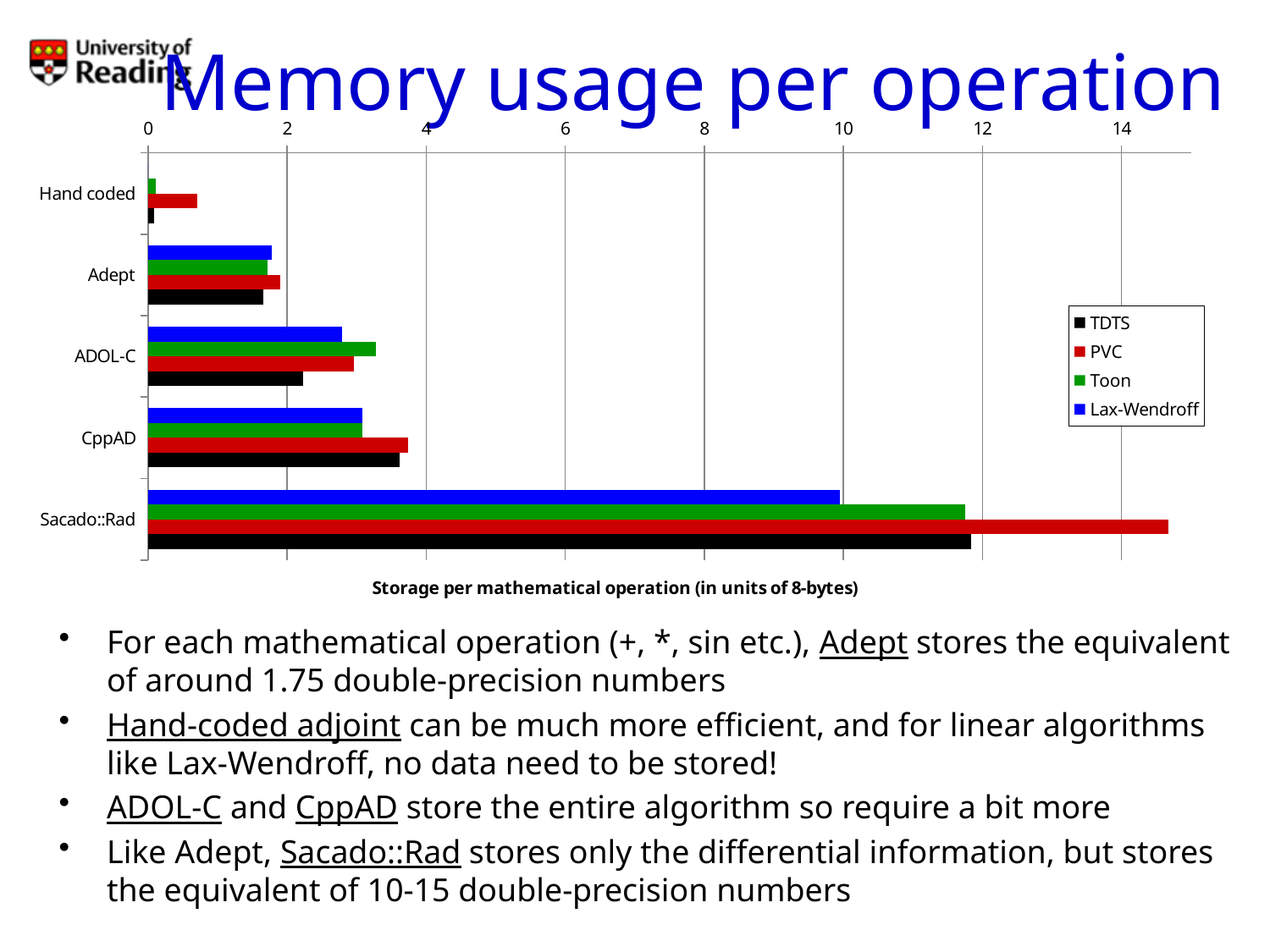
Which colour represents the Lax-Wendroff series in the chart? blue Is the Toon value for ADOL-C greater or less than 3? greater How many series does the chart's legend list? 4 What kind of chart is shown on the slide? bar chart Which category has the highest PVC value? Sacado::Rad Is the TDTS value for Adept greater or less than 2? less Which is larger: the PVC value for CppAD or the PVC value for ADOL-C? CppAD Which category has the lowest TDTS value? Hand coded How many categories (tools) are shown on the y axis of the chart? 5 What is the title of the x axis of the chart? Storage per mathematical operation (in units of 8-bytes) Is the PVC value for Sacado::Rad greater or less than 14? greater